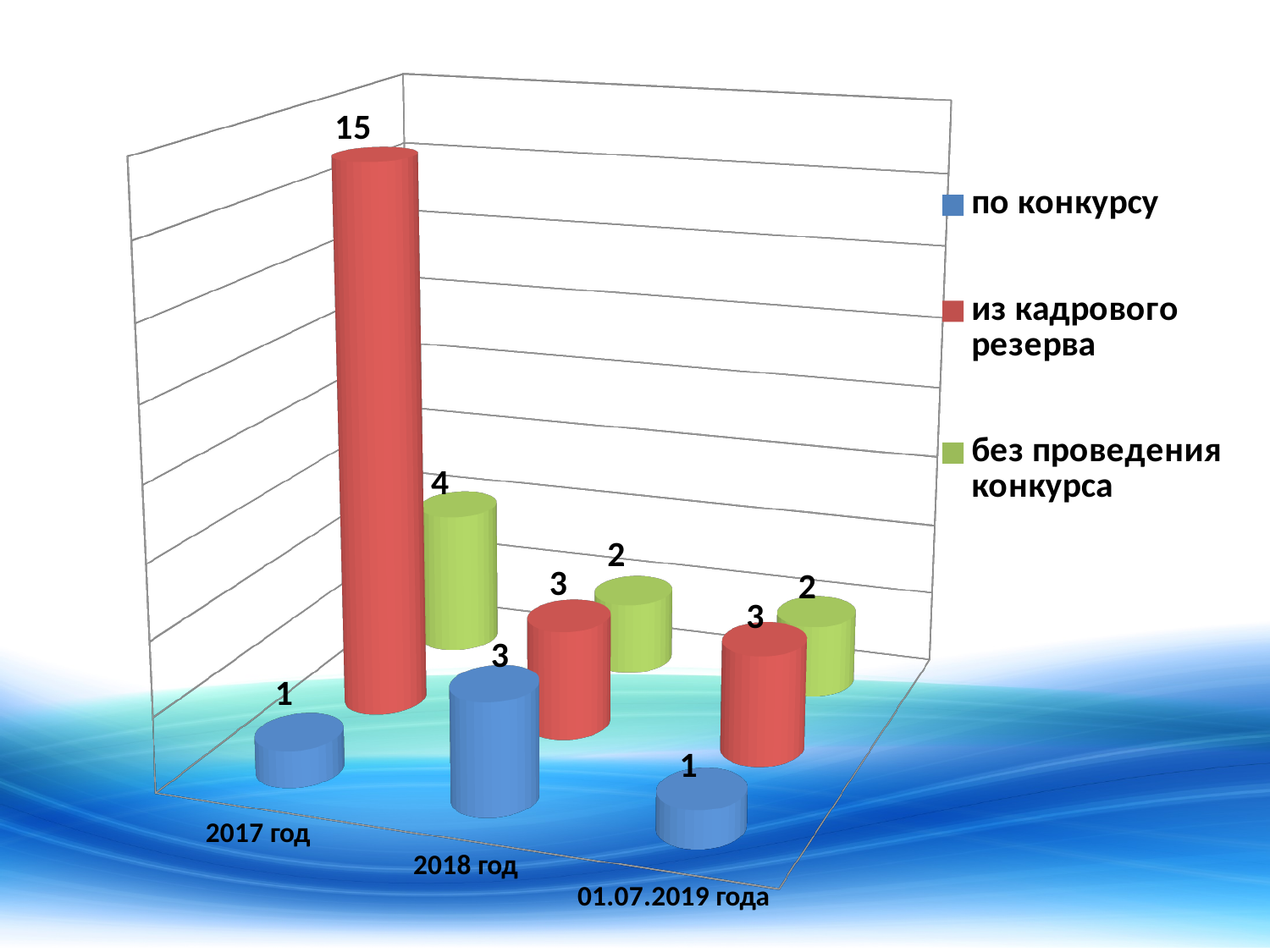
What is the difference between the "из кадрового резерва" values for 2017 год and 2018 год? 12 Which is larger in 2017 год: "по конкурсу" or "без проведения конкурса"? без проведения конкурса What is the value for "без проведения конкурса" in 01.07.2019 года? 2 Which colour represents "по конкурсу" in the legend? blue What is the value for "из кадрового резерва" in 2017 год? 15 What is the value for "без проведения конкурса" in 2017 год? 4 In which year does "из кадрового резерва" have its highest value? 2017 год How many series does the legend list? 3 How many categories are shown on the x axis? 3 In which category does "по конкурсу" have its highest value? 2018 год What kind of chart is shown on the slide? bar chart What is the value for "по конкурсу" in 2018 год? 3